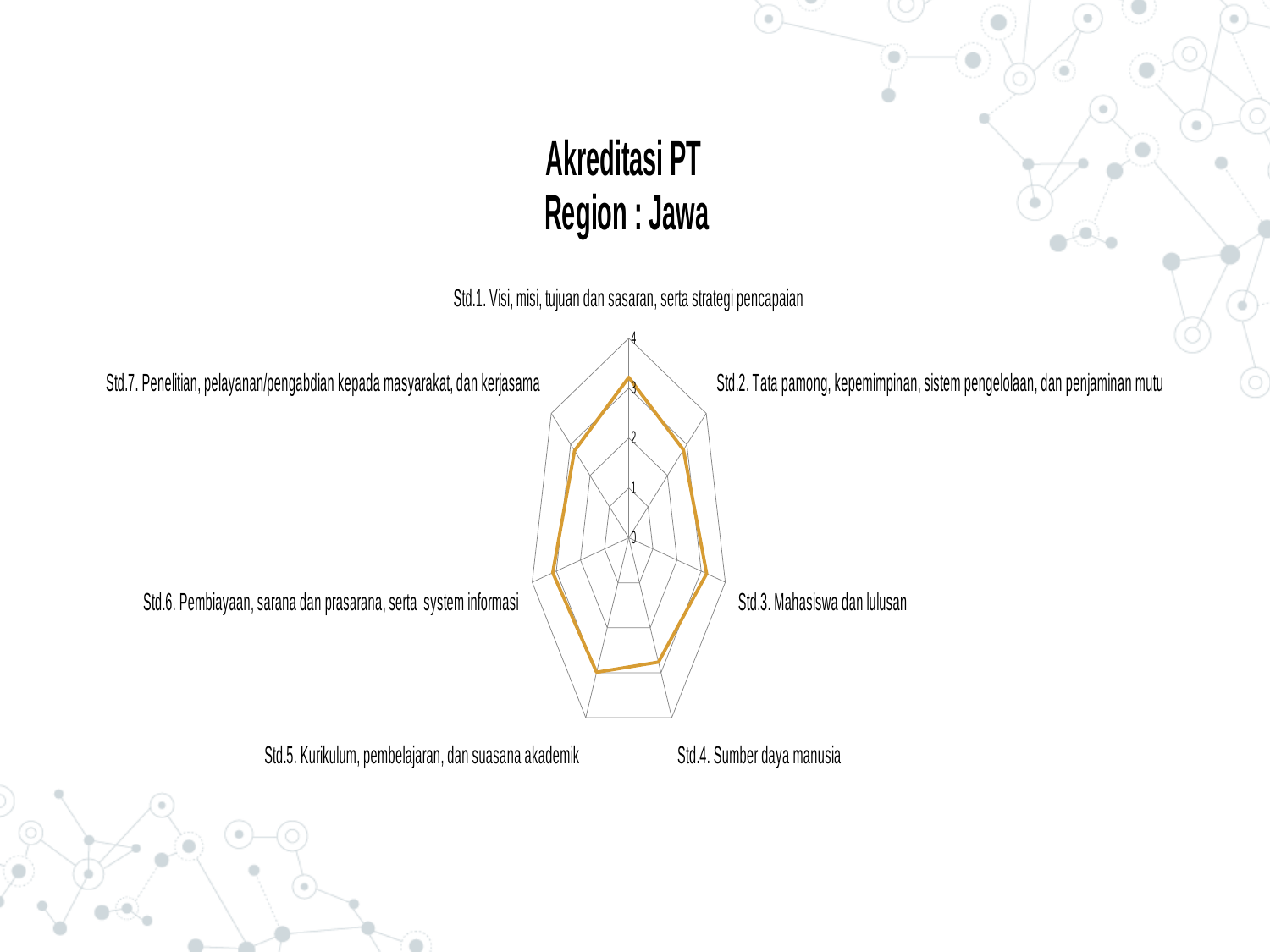
Is the value for Std.6. Pembiayaan, sarana dan prasarana, serta system informasi greater or less than 4? less Is the value for Std.7. Penelitian, pelayanan/pengabdian kepada masyarakat, dan kerjasama greater or less than 2? greater Is the value for Std.2. Tata pamong, kepemimpinan, sistem pengelolaan, dan penjaminan mutu greater or less than 4? less How many categories (standards) are plotted on the radar chart? 7 What is the maximum value shown on the radar chart's axis scale? 4 What kind of chart is shown on the slide? radar chart What is the title of the chart? Akreditasi PT Region : Jawa